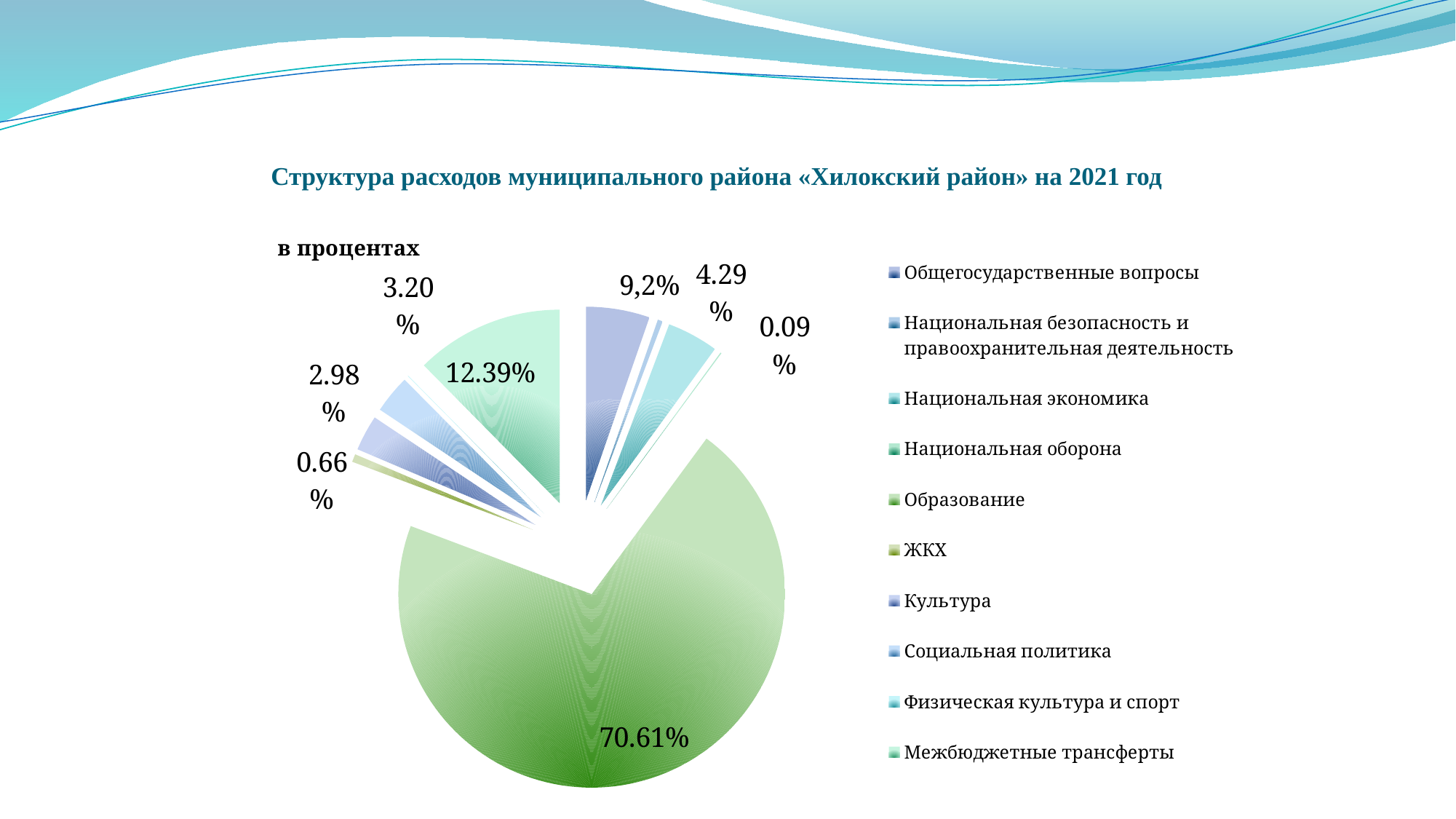
Which category has the largest slice of the pie? Образование What kind of chart is shown on the slide? pie chart What unit label is shown above the pie chart? в процентах What is the difference between the Образование slice (70.61%) and the Межбюджетные трансферты slice (12.39%)? 58.22% What is the largest value labelled on the pie chart? 70.61% What is the title of the chart? Структура расходов муниципального района «Хилокский район» на 2021 год Which is larger: the slice labelled 9,2% or the slice labelled 4.29%? 9,2% What share of the pie does Межбюджетные трансферты take? 12.39% How many entries does the chart legend list? 10 What share of the pie does Образование take? 70.61% What value is labelled on the slice for Общегосударственные вопросы? 9,2% What is the smallest value labelled on the pie chart? 0.09%